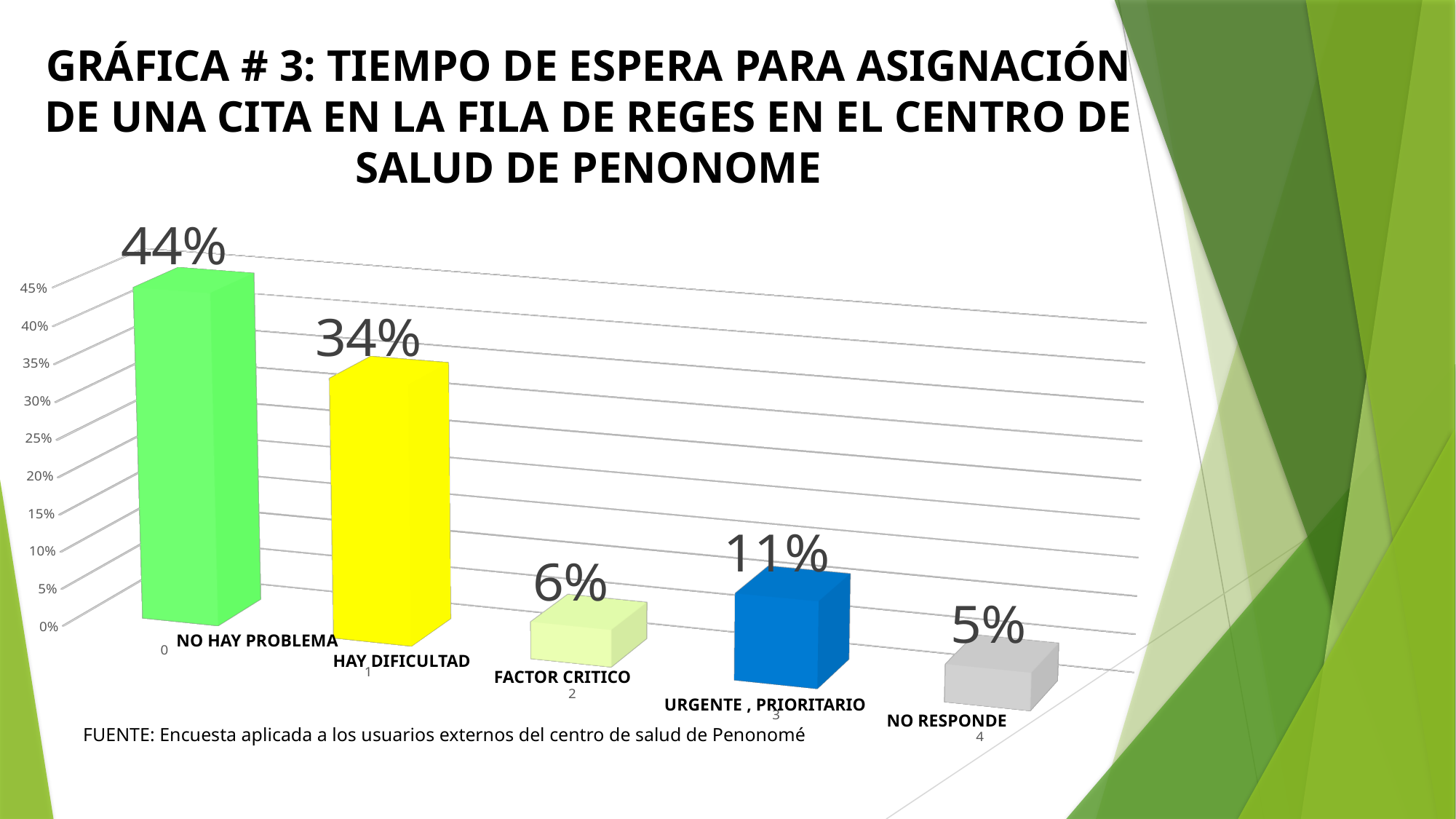
How many categories are shown in the chart? 5 What kind of chart is shown on the slide? Bar chart Which category has the lowest value? NO RESPONDE What colour is the bar for URGENTE , PRIORITARIO? Blue What is the value for FACTOR CRITICO? 6% What is the value for URGENTE , PRIORITARIO? 11% What is the value for HAY DIFICULTAD? 34% Which category has the highest value? NO HAY PROBLEMA Which is larger, the value for URGENTE , PRIORITARIO or the value for FACTOR CRITICO? URGENTE , PRIORITARIO What is the difference between the values for NO HAY PROBLEMA and HAY DIFICULTAD? 10% What is the value for NO HAY PROBLEMA? 44% What is the value for NO RESPONDE? 5%